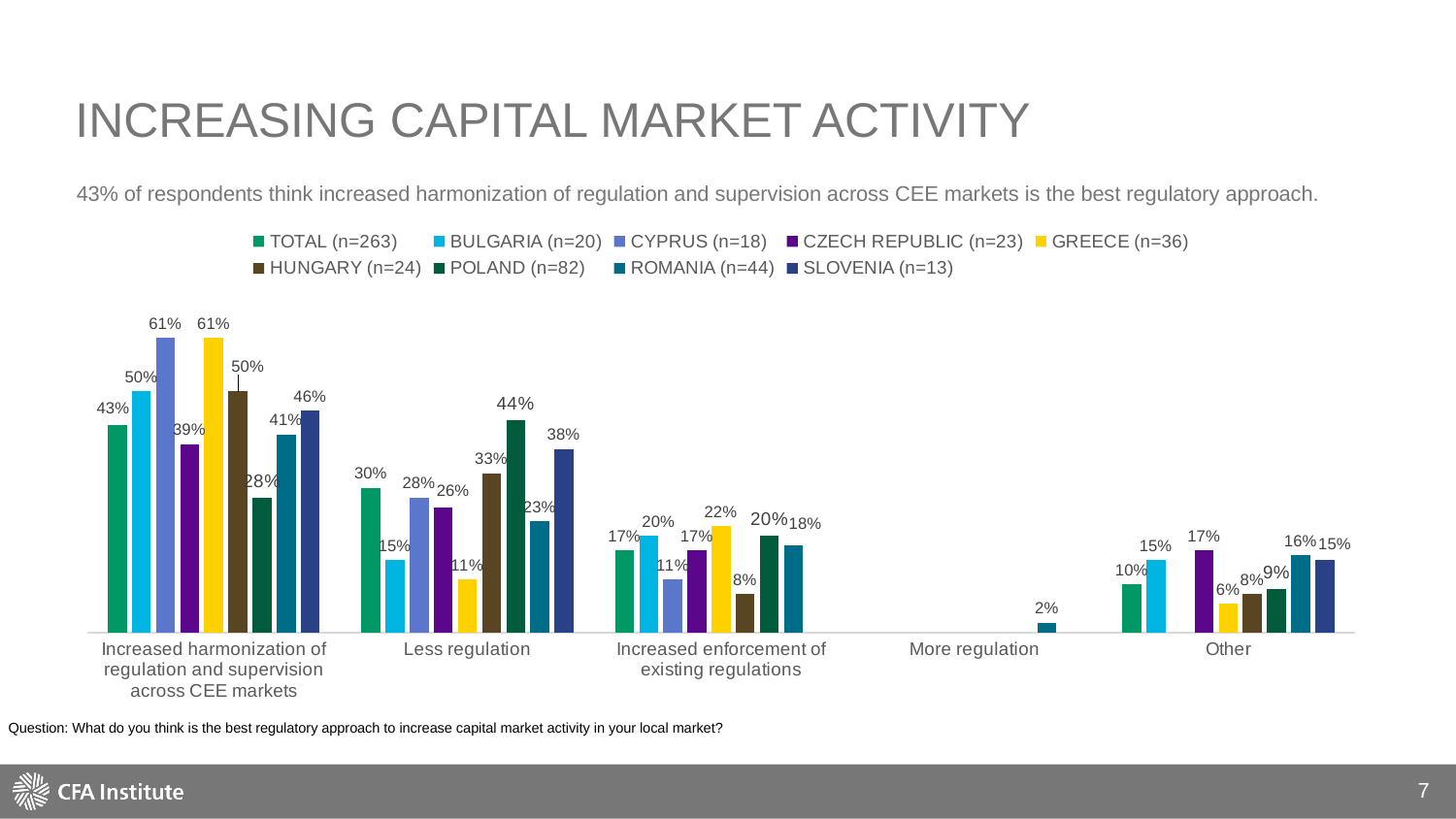
What is the POLAND (n=82) value for Less regulation? 44% Which series has the highest value for Less regulation? POLAND (n=82) What is the HUNGARY (n=24) value for Increased enforcement of existing regulations? 8% What is the TOTAL (n=263) value for Increased harmonization of regulation and supervision across CEE markets? 43% What is the sample size shown in the legend for CYPRUS? n=18 For the Other category, which is larger: the CZECH REPUBLIC (n=23) value or the GREECE (n=36) value? CZECH REPUBLIC (n=23) What is the difference between the SLOVENIA (n=13) and TOTAL (n=263) values for Less regulation? 8% What is the ROMANIA (n=44) value for More regulation? 2% How many series does the legend list? 9 How many regulatory approach categories are shown on the x axis? 5 What kind of chart is shown on the slide? bar chart Which series has the lowest value for Increased harmonization of regulation and supervision across CEE markets? POLAND (n=82)